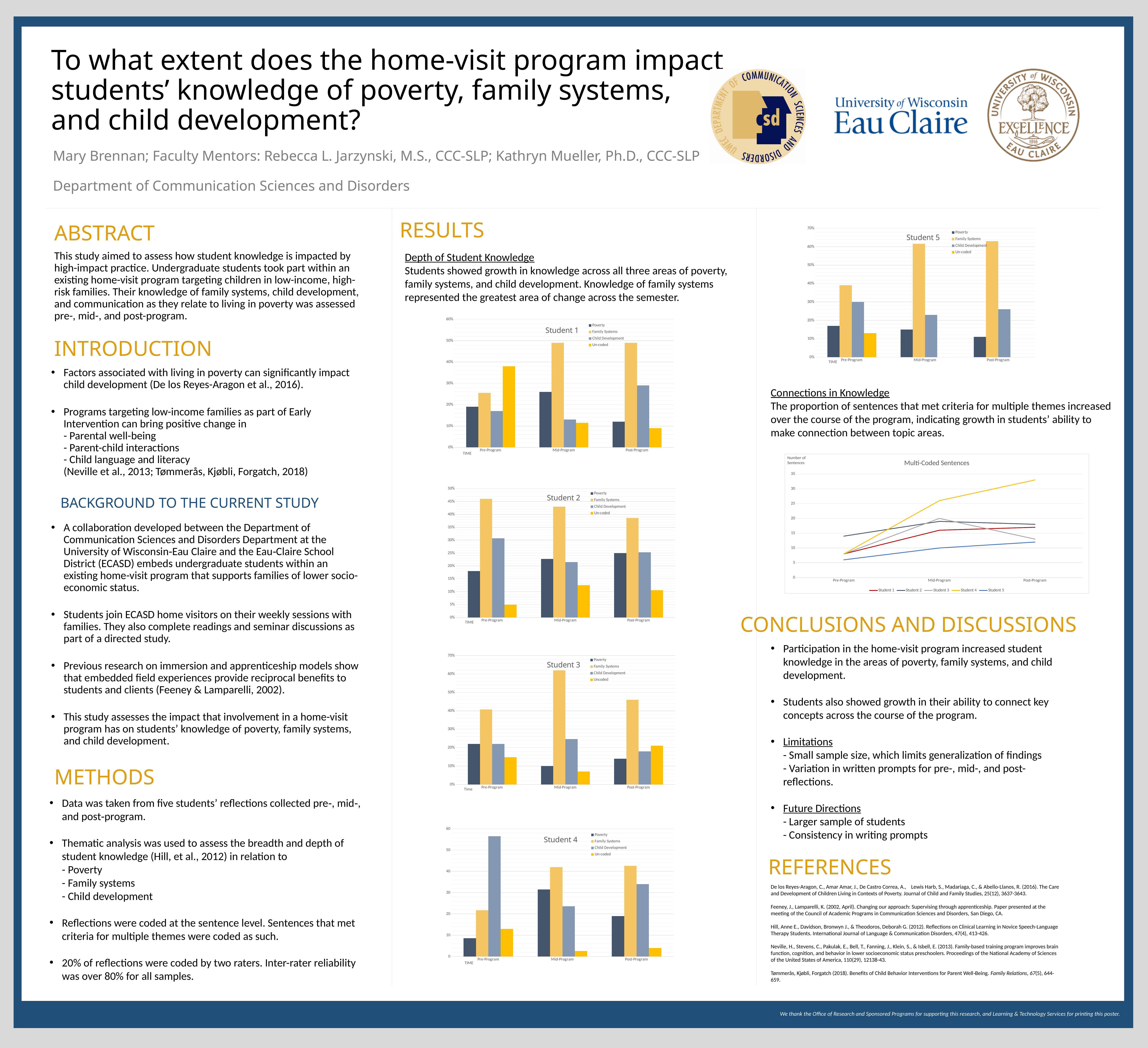
In the Student 5 chart, is the Poverty value at Post-Program greater or less than 20%? less What kind of chart is the Student 1 chart? bar chart In the Student 1 chart, is the Family Systems value at Mid-Program greater or less than 40%? greater How many series does the legend of the Student 1 chart list? 4 How many series does the legend of the Multi-Coded Sentences chart list? 5 In the Student 4 chart, which series has the highest bar at Pre-Program? Child Development In the Student 2 chart, is the Un-coded value at Pre-Program greater or less than 10%? less What kind of chart is the Multi-Coded Sentences chart? line chart How many time-point categories are shown on the x axis of the Student 2 chart? 3 In the Student 3 chart, is the Family Systems value larger at Mid-Program or at Post-Program? Mid-Program In the Multi-Coded Sentences chart, which student has the highest value at Post-Program? Student 4 In the Student 3 chart, which series has the highest bar at Mid-Program? Family Systems